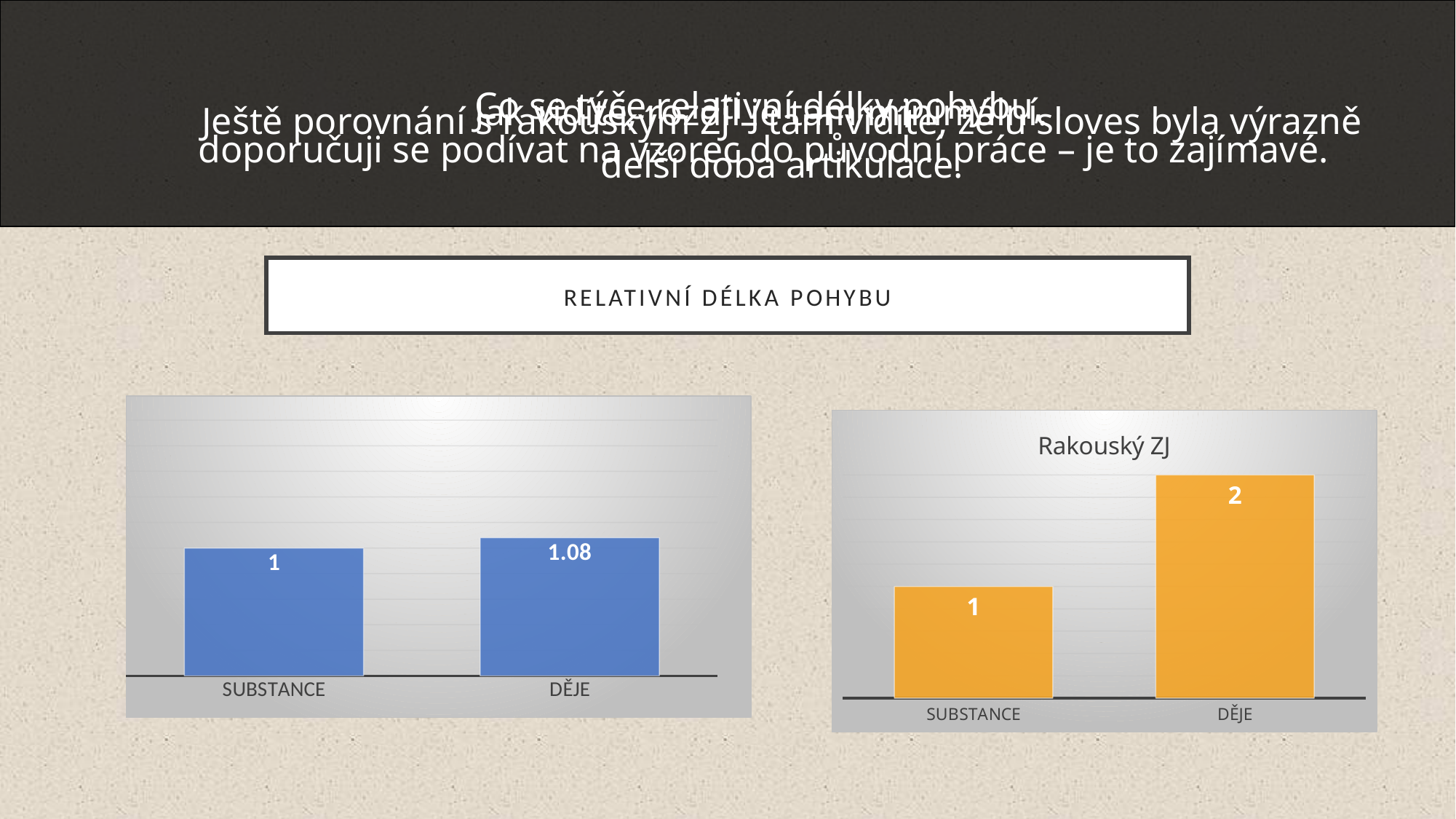
In the left chart, what is the value for DĚJE? 1.08 In the chart titled Rakouský ZJ, what is the value for DĚJE? 2 In the chart titled Rakouský ZJ, what is the difference between the values for DĚJE and SUBSTANCE? 1 In the left chart, what is the difference between the values for DĚJE and SUBSTANCE? 0.08 In the chart titled Rakouský ZJ, which category has the lowest value? SUBSTANCE In the left chart, what is the value for SUBSTANCE? 1 In the left chart, which is larger, the value for SUBSTANCE or the value for DĚJE? DĚJE What kind of chart is the left chart? bar chart What is the title of the right chart? Rakouský ZJ In the chart titled Rakouský ZJ, which category has the highest value? DĚJE In the chart titled Rakouský ZJ, what is the value for SUBSTANCE? 1 How many categories does the chart titled Rakouský ZJ show? 2